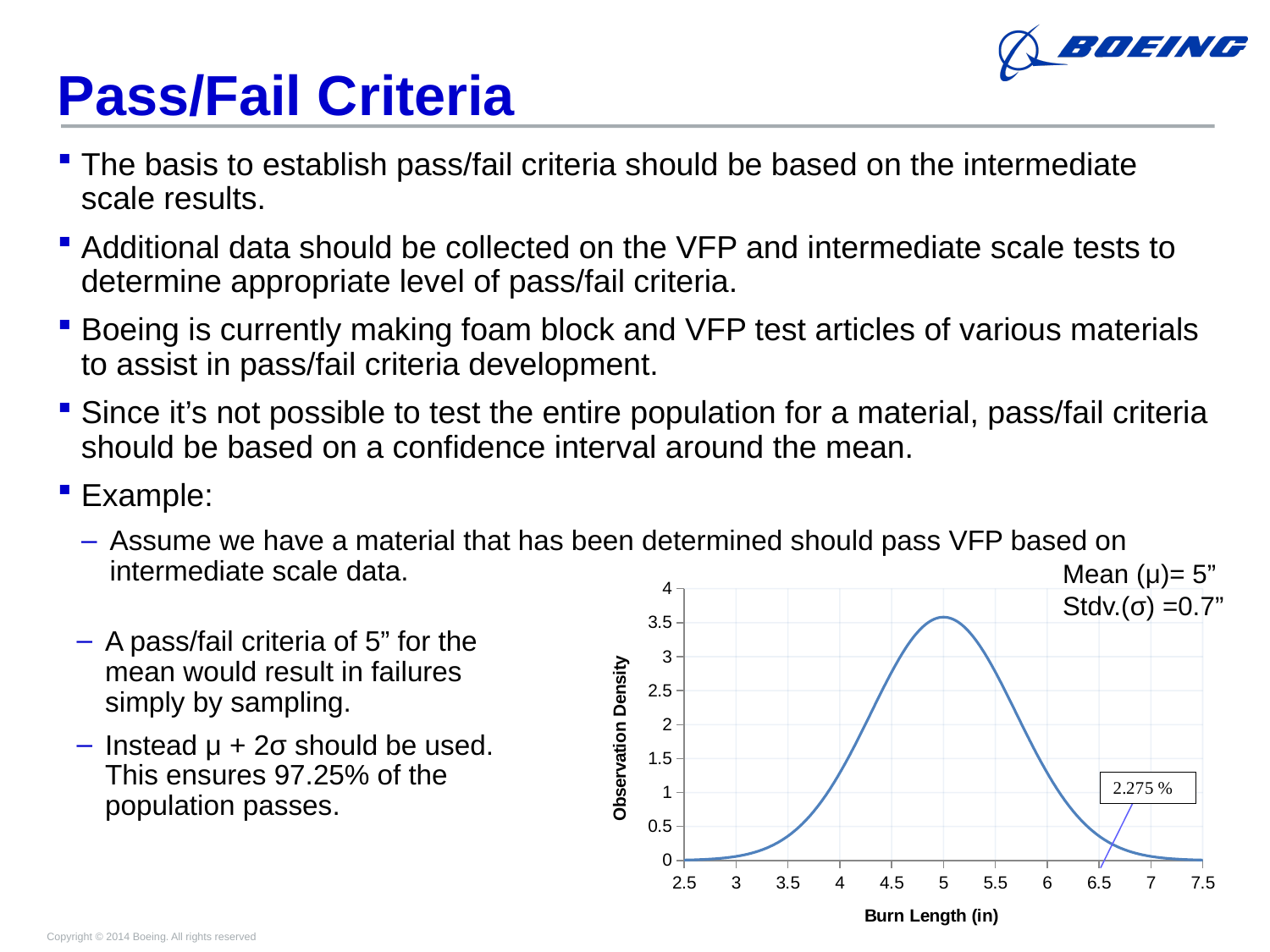
What kind of chart is shown on the slide? line chart Is the observation density at a burn length of 4.5 in greater or less than 2? greater Is the observation density at a burn length of 5 in greater or less than 4? less Does the observation density rise or fall as burn length increases from 5 to 7.5 in? fall What is the title of the y axis of the chart? Observation Density What is the title of the x axis of the chart? Burn Length (in) Is the observation density at a burn length of 6.5 in greater or less than 0.5? less What percentage is shown in the annotation box pointing to the curve near a burn length of 6.5 in? 2.275 % Does the observation density rise or fall as burn length increases from 2.5 to 5 in? rise At which burn length does the curve reach its highest observation density? 5